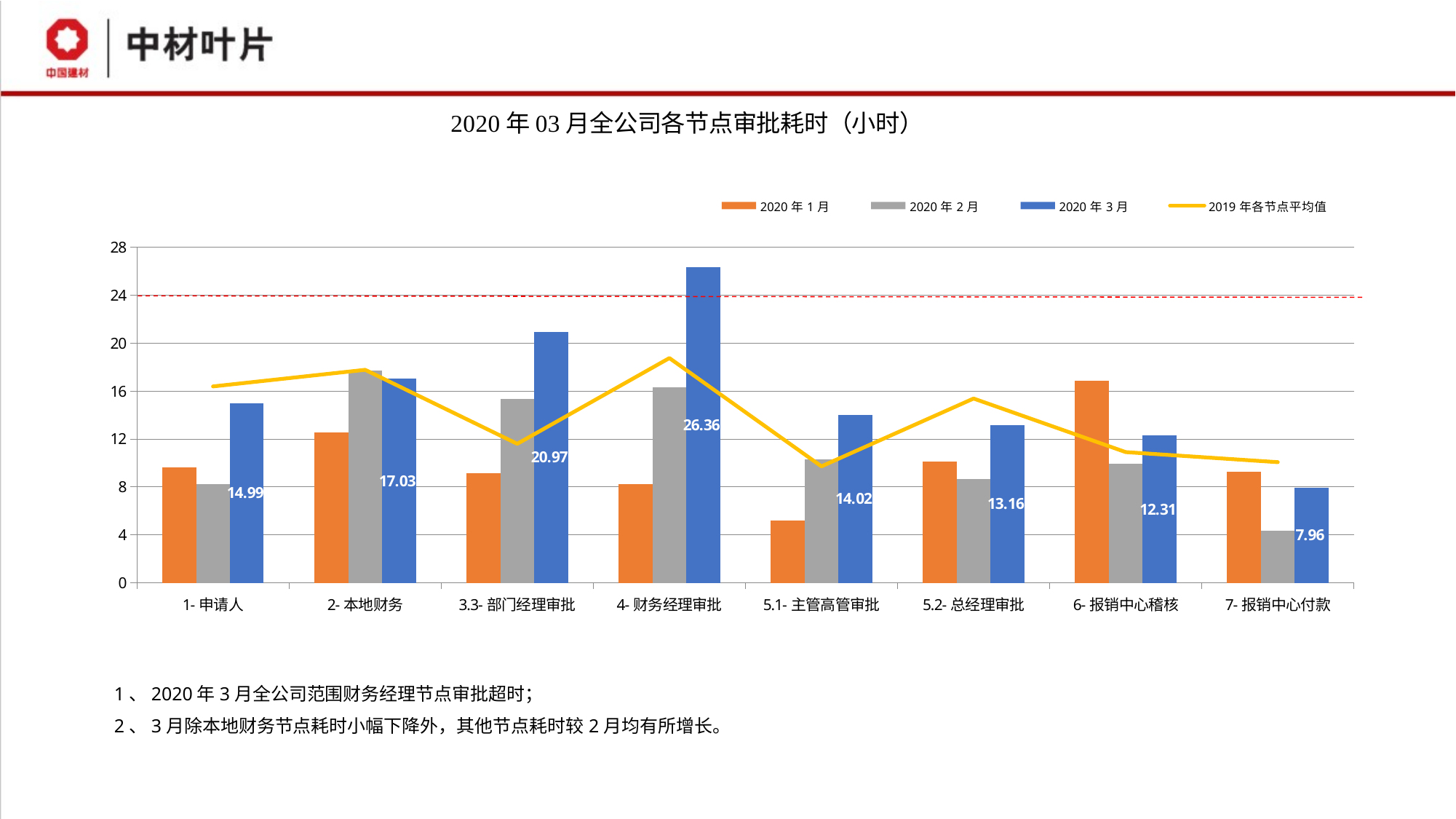
What is the difference between the 2020年3月 values for 4- 财务经理审批 and 7- 报销中心付款? 18.40 What is the 2020年3月 value for 4- 财务经理审批? 26.36 Which category has the highest 2020年3月 value? 4- 财务经理审批 What is the 2020年3月 value for 7- 报销中心付款? 7.96 How many categories are shown on the x axis? 8 What kind of chart is this? combination bar and line chart What is the 2020年3月 value for 2- 本地财务? 17.03 Do the 2020年3月 values rise or fall from 4- 财务经理审批 to 7- 报销中心付款? fall How many series does the legend list? 4 Is the 2020年1月 value for 5.1- 主管高管审批 greater or less than 8? less Which is larger for 2020年3月: 3.3- 部门经理审批 or 5.1- 主管高管审批? 3.3- 部门经理审批 Which category has the lowest 2020年3月 value? 7- 报销中心付款